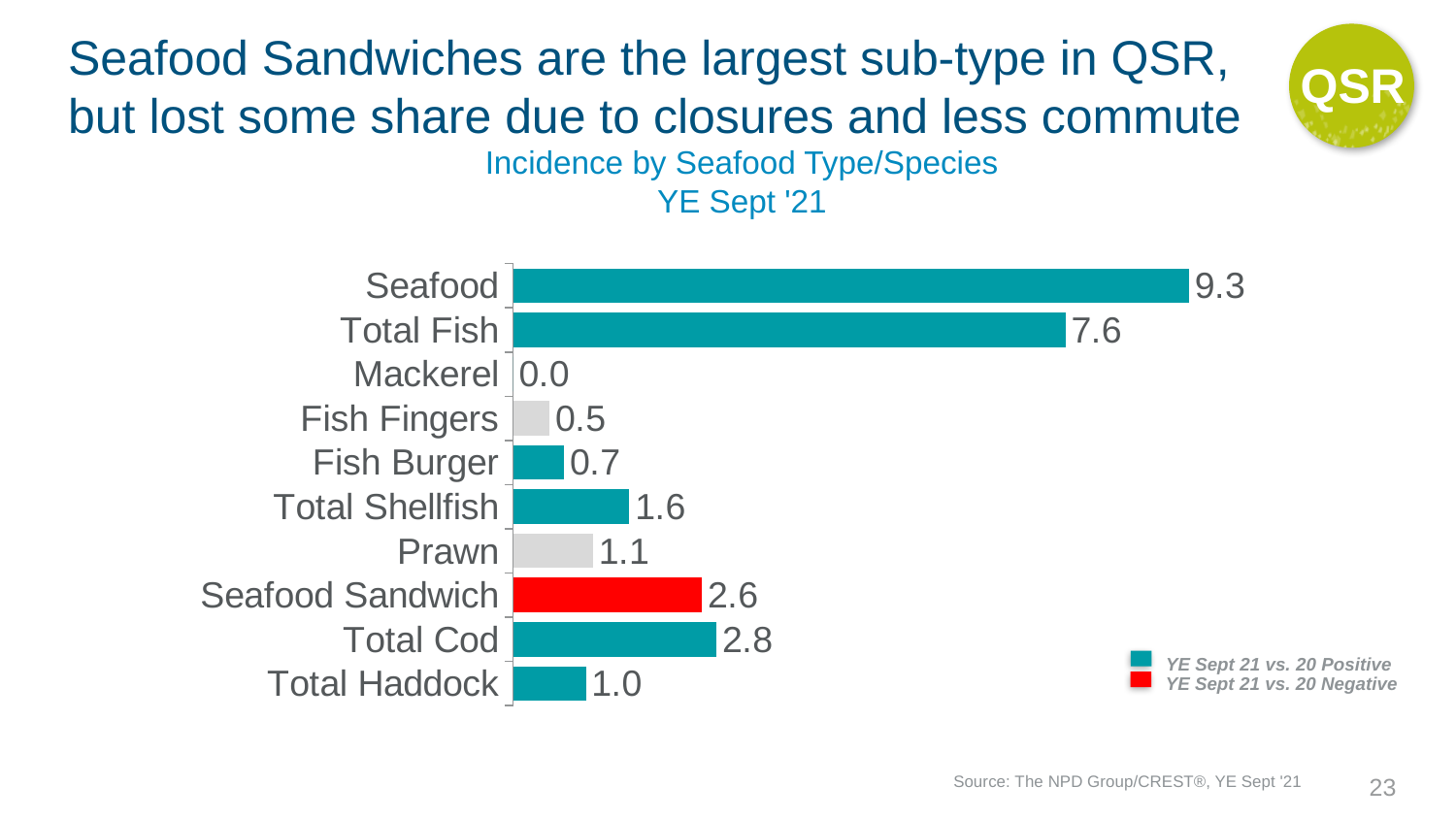
Which category is shown with a red bar, indicating a negative change YE Sept 21 vs. 20? Seafood Sandwich What is the value for Total Fish? 7.6 What is the difference between the values for Total Cod and Seafood Sandwich? 0.2 Which category has the highest value? Seafood Which is larger, the value for Total Shellfish or the value for Prawn? Total Shellfish What is the value for Seafood? 9.3 What is the value for Total Haddock? 1.0 What is the value for Seafood Sandwich? 2.6 Which category has the lowest value? Mackerel How many categories are shown in the chart? 10 What kind of chart is shown on the slide? Bar chart What is the difference between the values for Seafood and Total Fish? 1.7